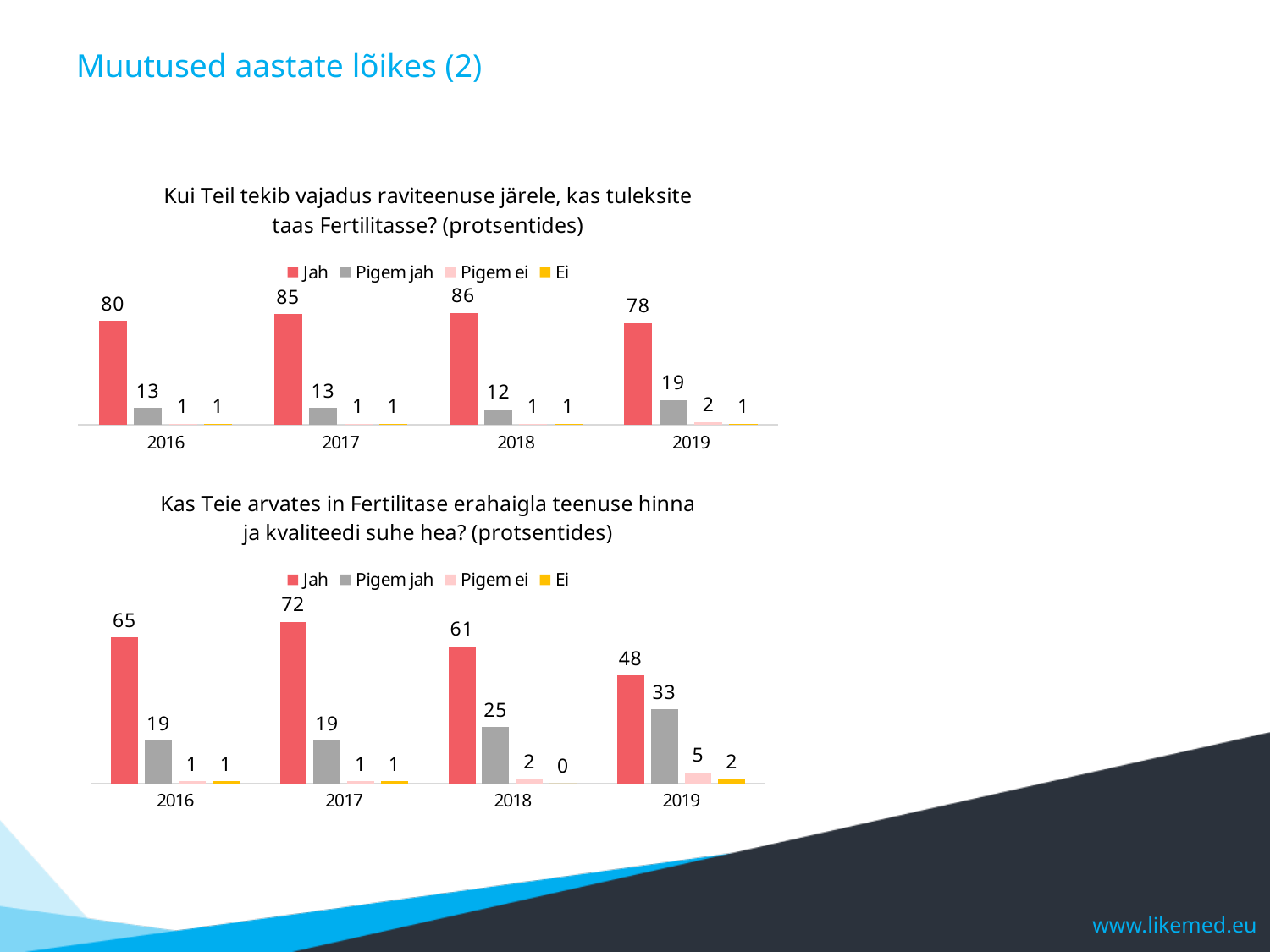
In the bottom chart, which year has the highest value for Pigem jah? 2019 In the top chart, what is the value for Jah in 2018? 86 In the bottom chart, what is the difference between the Jah values for 2017 and 2018? 11 What kind of chart is the bottom chart? bar chart In the top chart, what is the value for Pigem jah in 2019? 19 In the top chart, what is the difference between the Jah values for 2017 and 2019? 7 In the bottom chart, is the Jah value for 2016 larger or smaller than the Jah value for 2019? larger In the top chart, which year has the lowest value for Jah? 2019 In the top chart, how many series does the legend list? 4 In the top chart, which year has the highest value for Jah? 2018 In the bottom chart, what is the value for Jah in 2019? 48 In the bottom chart, what is the value for Pigem ei in 2019? 5